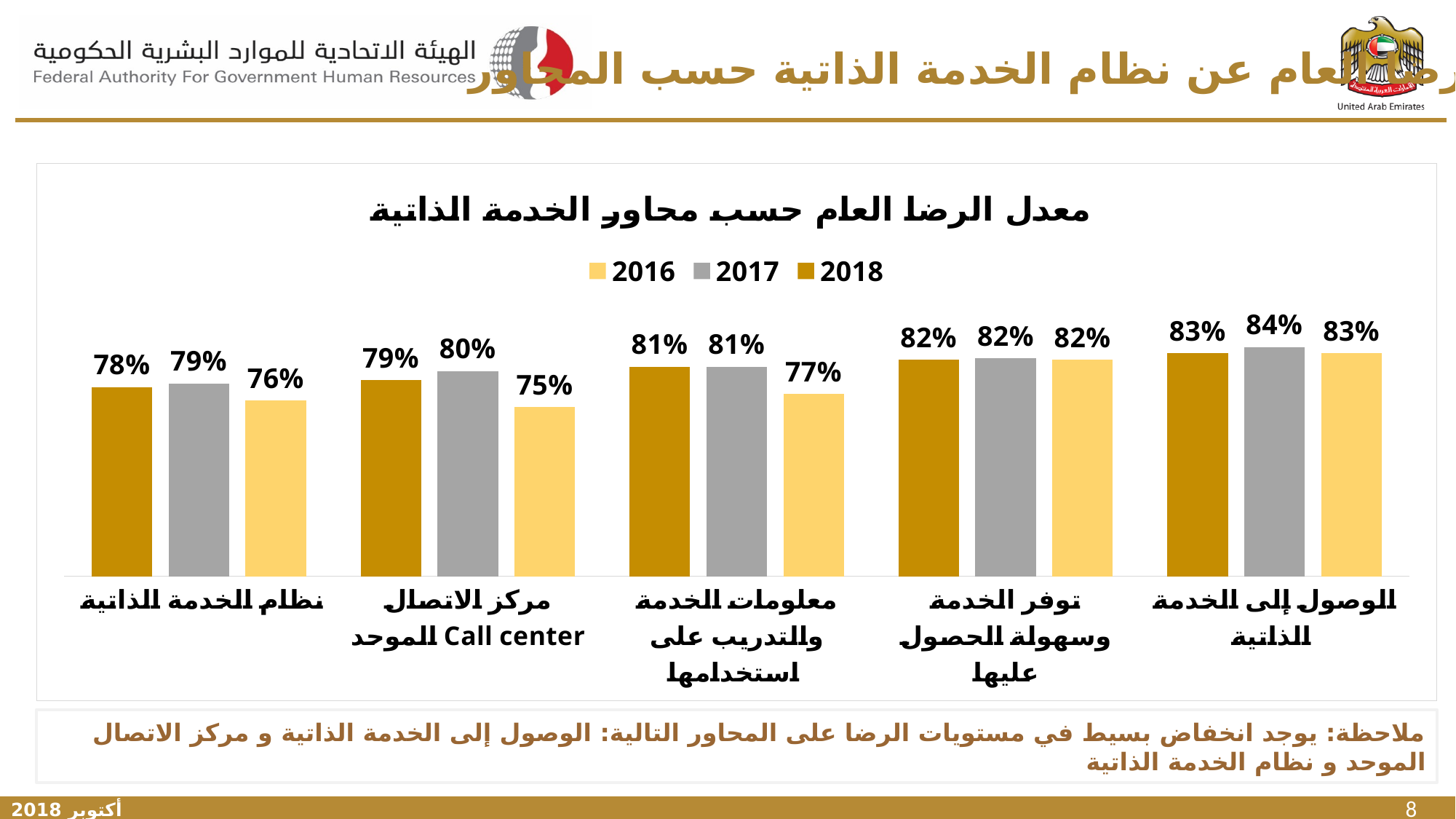
What is the 2016 value for معلومات الخدمة والتدريب على استخدامها? 77% Which category has the lowest 2016 value? مركز الاتصال الموحد Call center What type of chart is shown on the slide? bar chart Which year is shown in gray in the legend? 2017 Which category has the highest 2017 value? الوصول إلى الخدمة الذاتية How many series does the legend list? 3 What is the difference between the 2017 and 2016 values for مركز الاتصال الموحد Call center? 5% What is the 2016 value for نظام الخدمة الذاتية? 76% Which is larger for نظام الخدمة الذاتية: the 2018 value or the 2016 value? 2018 What is the 2018 value for مركز الاتصال الموحد Call center? 79% What is the 2017 value for الوصول إلى الخدمة الذاتية? 84% How many categories are shown on the x axis? 5